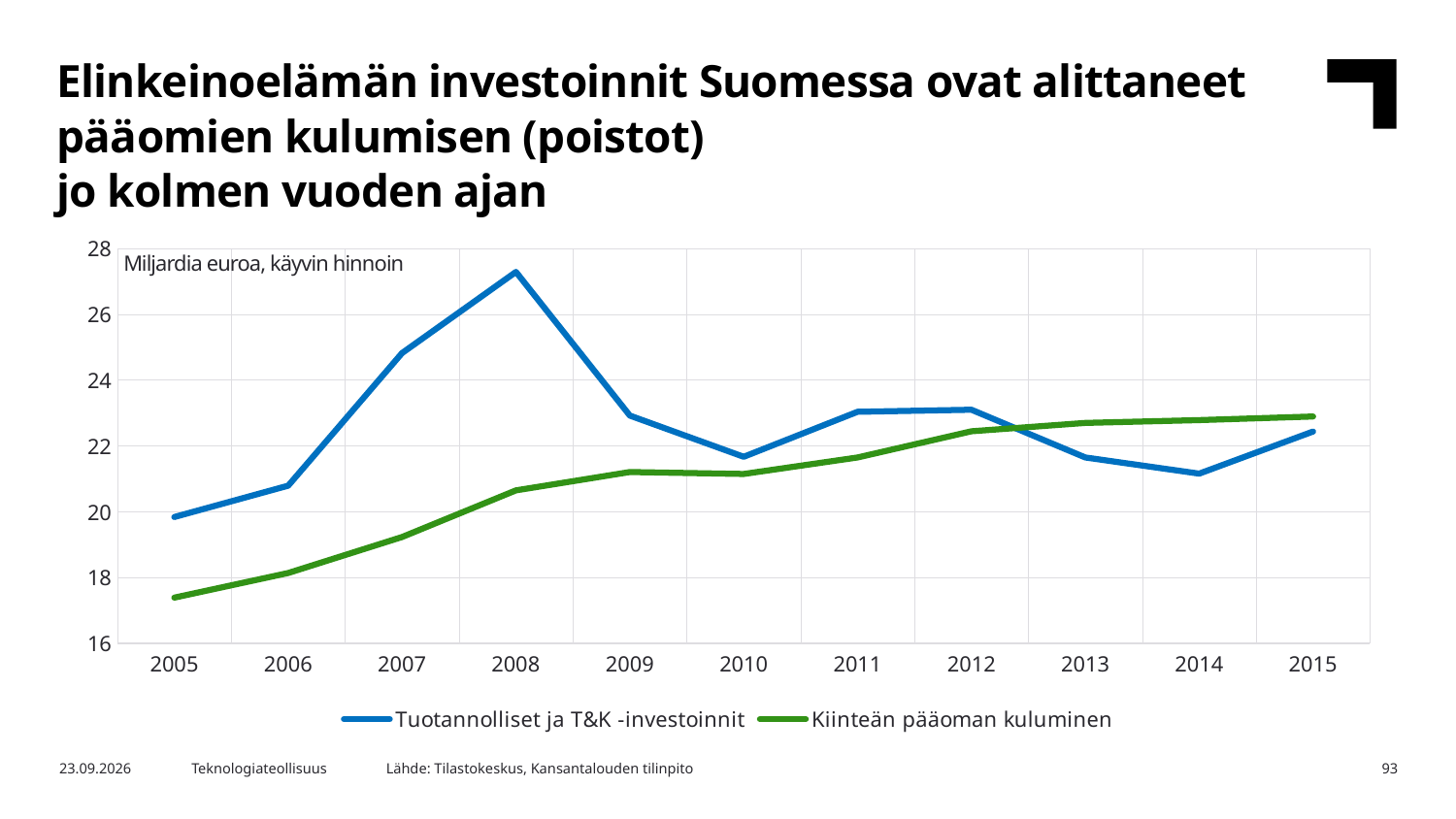
In which year is the value for Tuotannolliset ja T&K -investoinnit lowest? 2005 In which year is the value for Kiinteän pääoman kuluminen lowest? 2005 How many series does the legend list? 2 Which series has the larger value in 2014, Tuotannolliset ja T&K -investoinnit or Kiinteän pääoman kuluminen? Kiinteän pääoman kuluminen Does the value for Kiinteän pääoman kuluminen rise or fall from 2005 to 2015? rise Is the value for Tuotannolliset ja T&K -investoinnit in 2010 greater or less than 22? less What unit label is shown in the top-left corner of the chart? Miljardia euroa, käyvin hinnoin How many years are shown on the x axis? 11 Is the value for Tuotannolliset ja T&K -investoinnit in 2008 greater or less than 26? greater In which year is the value for Tuotannolliset ja T&K -investoinnit highest? 2008 Is the value for Kiinteän pääoman kuluminen in 2005 greater or less than 18? less What kind of chart is shown on the slide? line chart